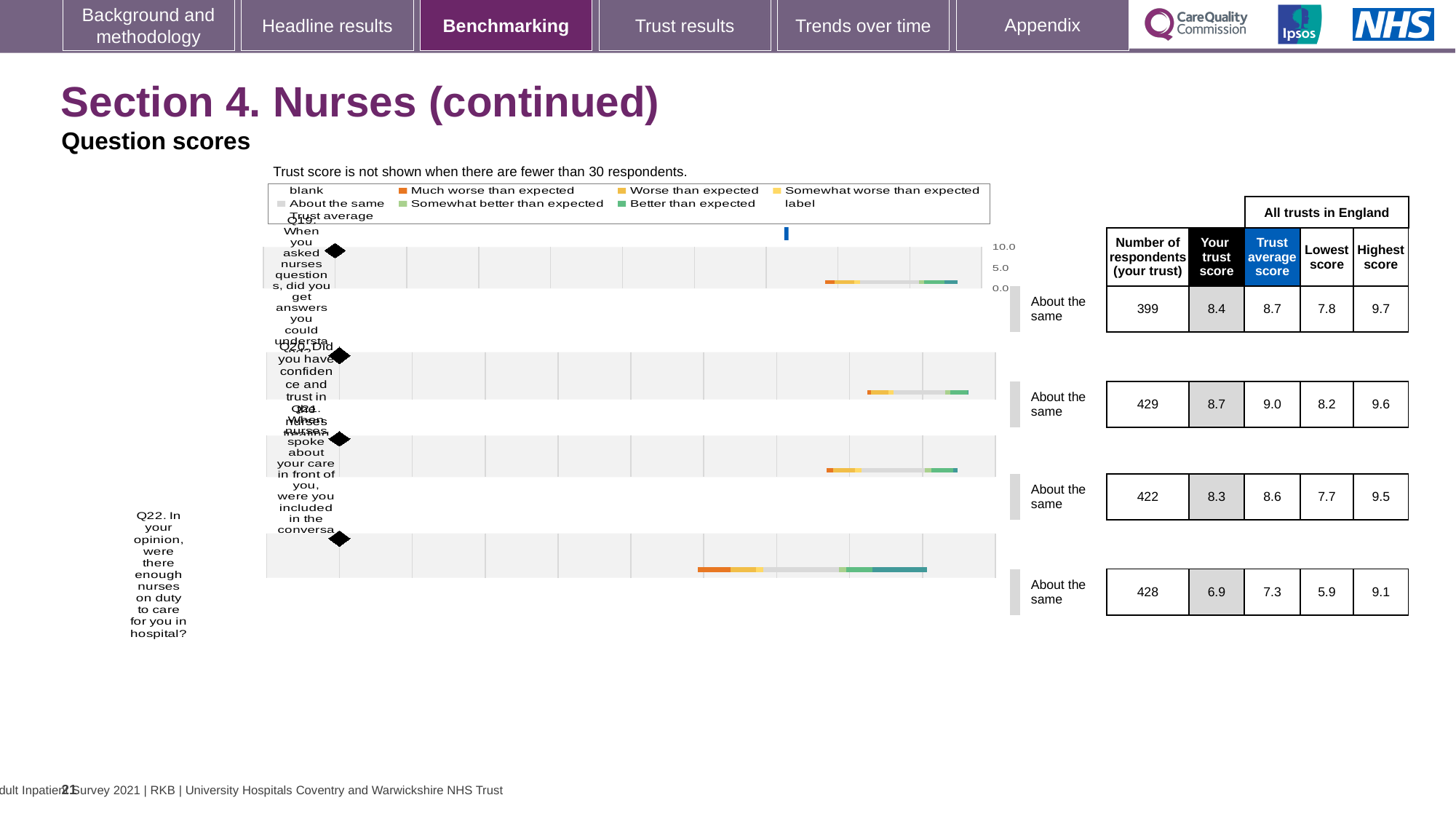
Which has the larger 'Your trust score', Q19 or Q20? Q20 What benchmark category is shown for all four questions? About the same How many questions (categories) are plotted in the chart? 4 What is the difference between the 'Trust average score' and 'Your trust score' for Q22? 0.4 How many respondents answered Q21 (included in the conversation)? 422 What is the 'Trust average score' for Q20 (confidence and trust in nurses)? 9.0 Which question has the lowest 'Your trust score'? Q22 Which question has the highest number of respondents? Q20 What is the highest value shown on the chart's score axis? 10.0 What type of chart is used to show the question scores on this slide? bar chart What is the 'Highest score' for Q19 (answers you could understand)? 9.7 What is the 'Your trust score' for Q22 (were there enough nurses on duty)? 6.9